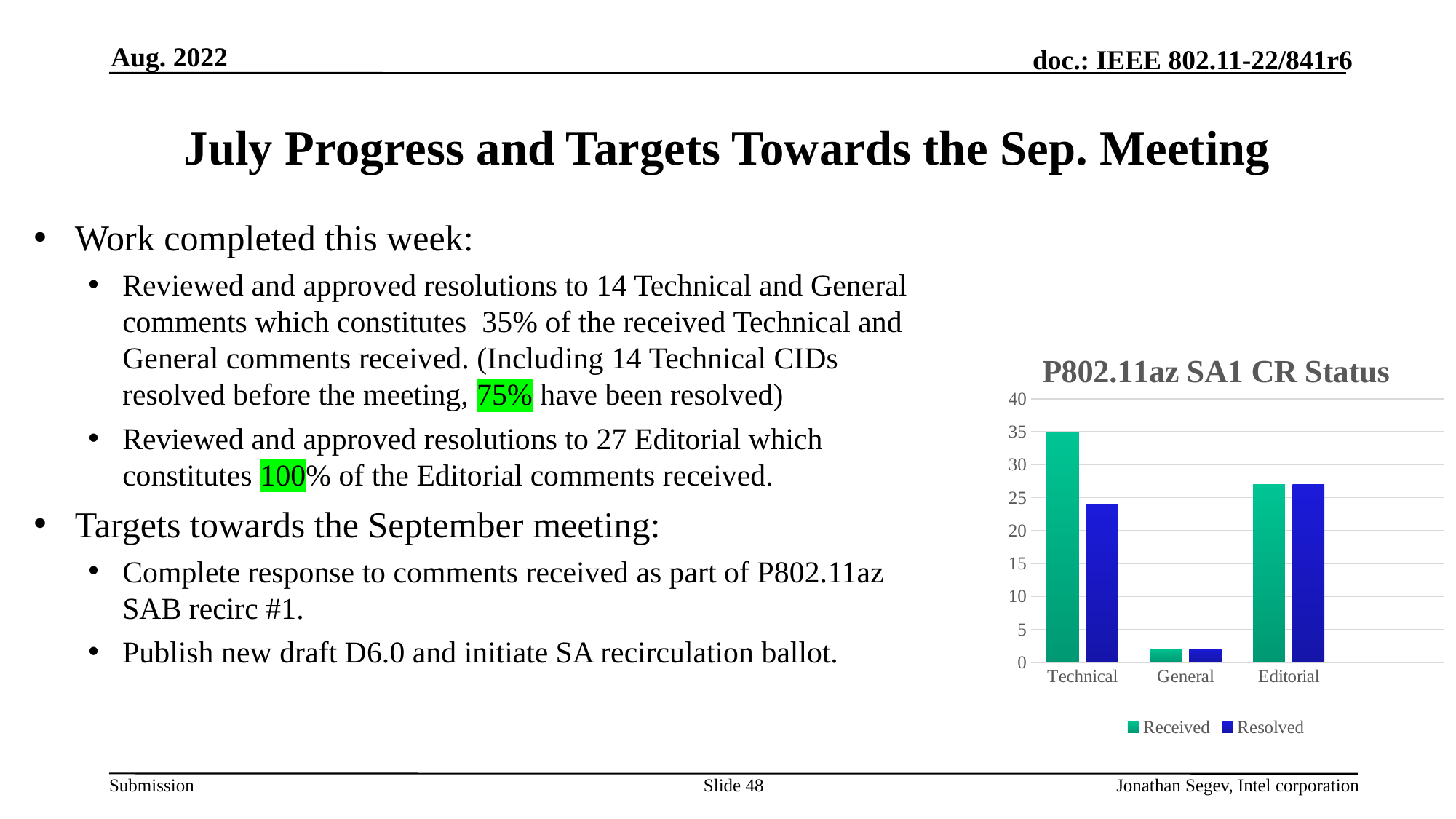
Is the Resolved value for Editorial greater or less than 25? greater How many categories are shown on the x axis of the chart? 3 How many series does the chart's legend list? 2 For the Technical category, which is larger: Received or Resolved? Received What kind of chart is shown on the slide? bar chart What are the two series named in the chart's legend? Received and Resolved Is the Received value for Technical greater or less than 30? greater Is the Resolved value for Technical greater or less than 20? greater Which category has the lowest Received value? General Which category has the highest Received value? Technical What is the title of the chart? P802.11az SA1 CR Status